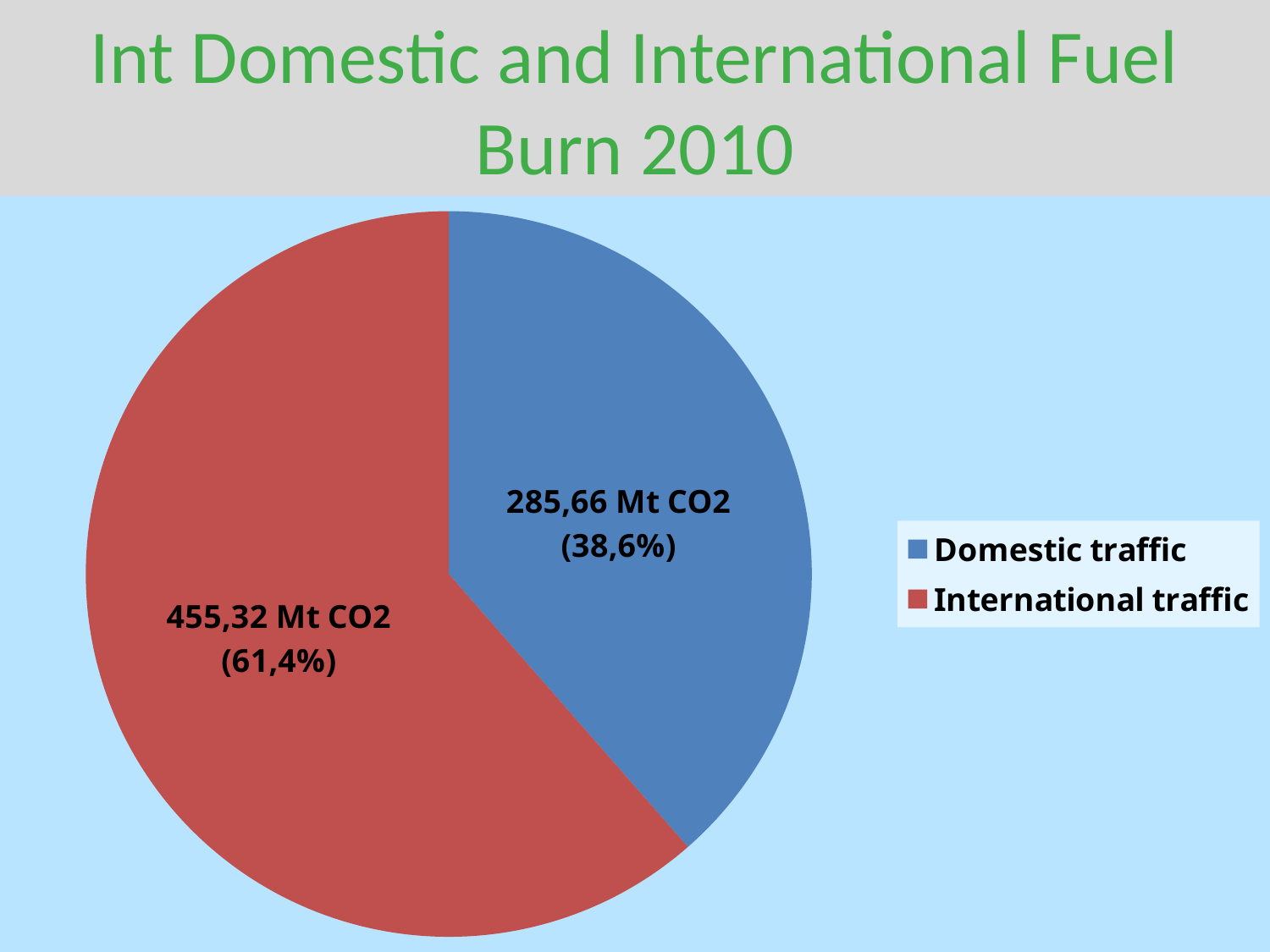
What share of the pie does International traffic represent? 61,4% What is the value for International traffic? 455,32 Mt CO2 What kind of chart is shown on the slide? pie chart Which is larger, Domestic traffic or International traffic? International traffic What is the value for Domestic traffic? 285,66 Mt CO2 How many slices does the pie chart have? 2 Which category has the largest slice? International traffic What is the difference between International traffic and Domestic traffic in Mt CO2? 169,66 Mt CO2 What colour is the International traffic slice? red What share of the pie does Domestic traffic represent? 38,6% What is the title of the slide? Int Domestic and International Fuel Burn 2010 Which category has the smallest slice? Domestic traffic